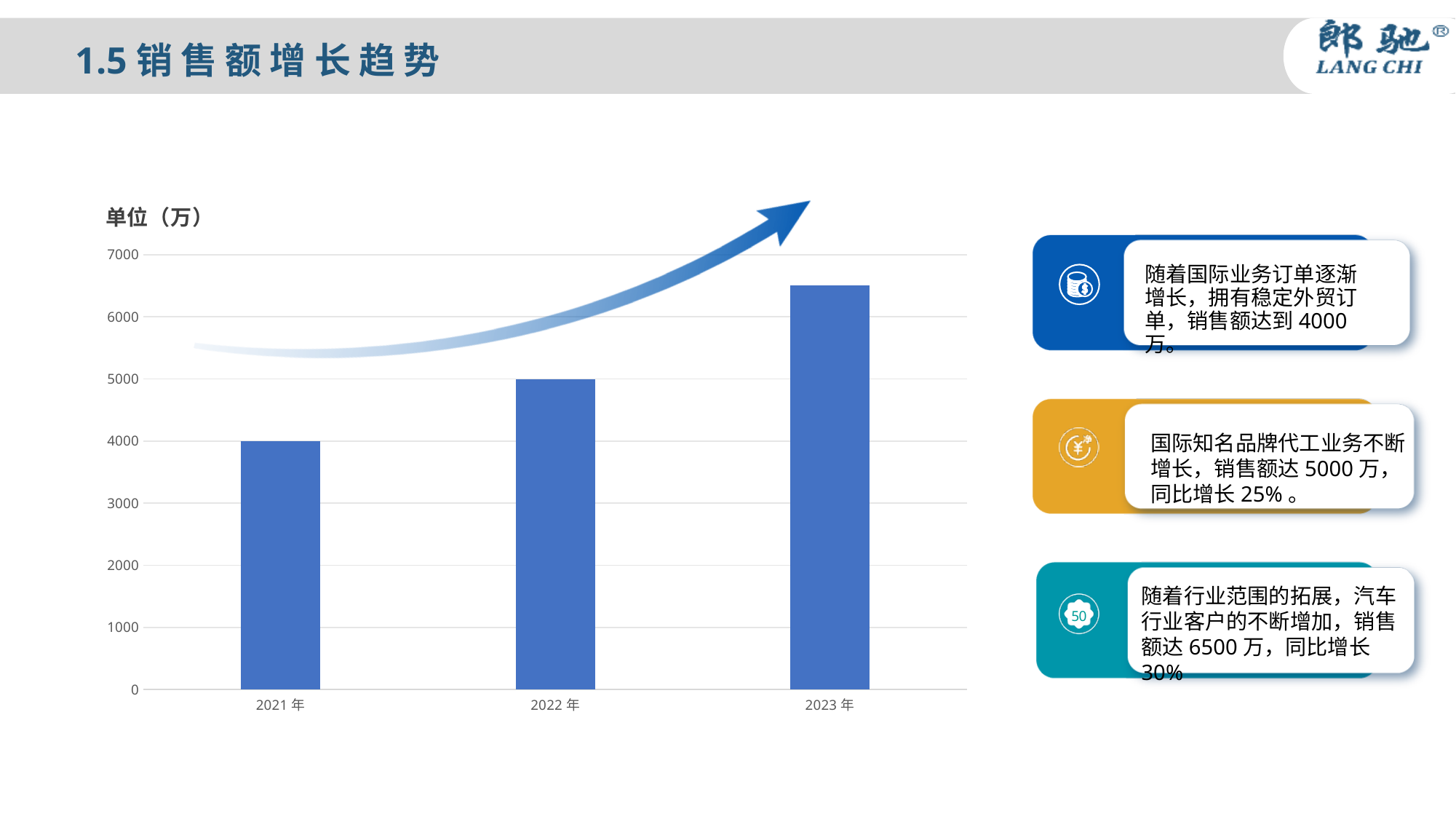
What kind of chart is shown on the slide? bar chart Which is larger, the value for 2023 年 or the value for 2022 年? 2023 年 What is the difference between the values for 2022 年 and 2021 年? 1000 Is the value for 2023 年 greater or less than 6000? greater Which year has the lowest bar? 2021 年 What is the value for 2022 年? 5000 Which year has the highest bar? 2023 年 Is the value for 2021 年 greater or less than 5000? less Do the values rise or fall from 2021 年 to 2023 年? rise What unit label is shown above the chart? 单位（万） What is the value for 2021 年? 4000 How many bars are shown in the chart? 3